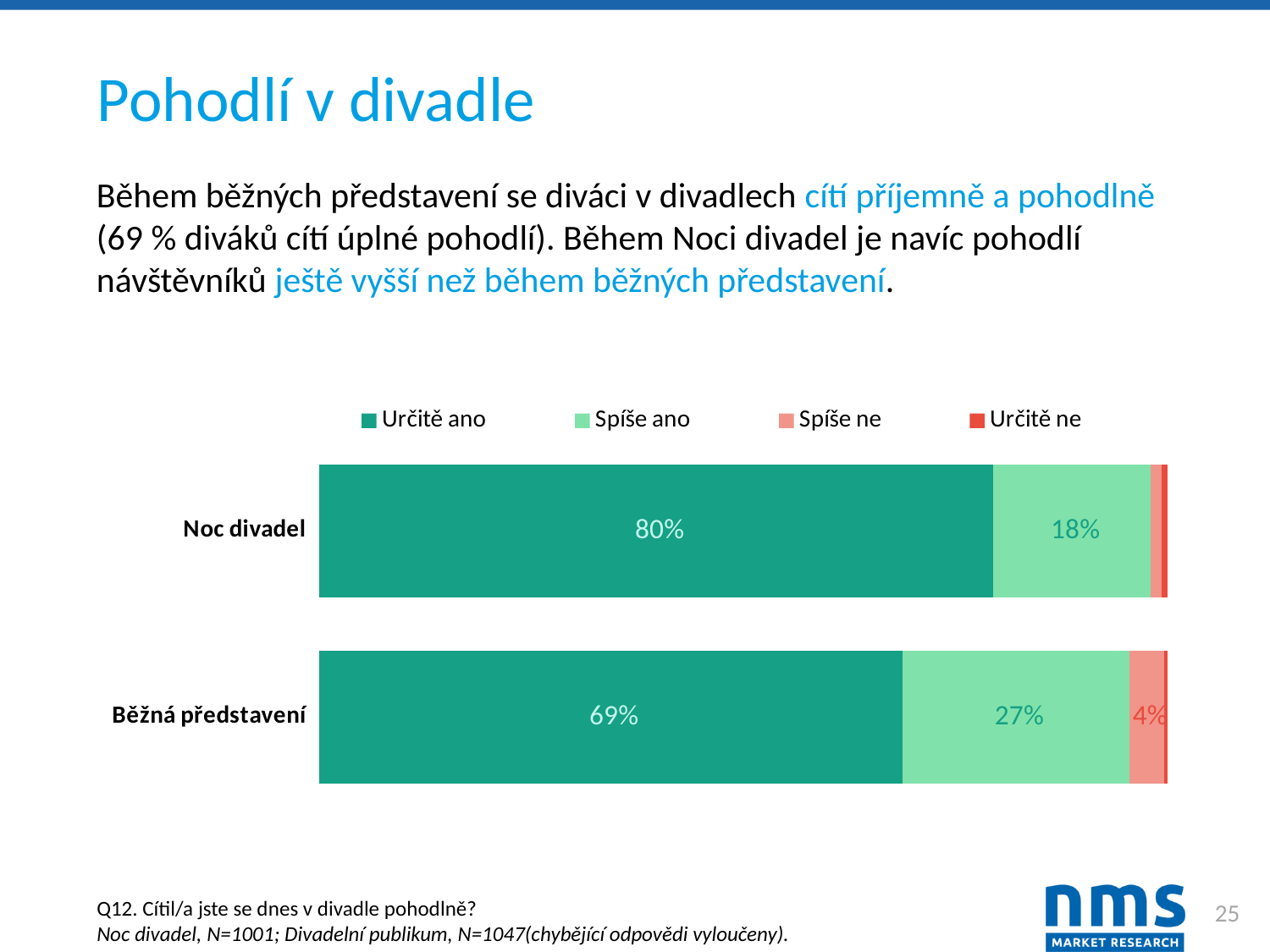
How many series does the legend list? 4 What is the difference between the "Určitě ano" values for Noc divadel and Běžná představení? 11% How many categories are plotted in the chart? 2 What is the value of "Spíše ne" for Běžná představení? 4% What is the value of "Spíše ano" for Noc divadel? 18% What is the difference between the "Spíše ano" values for Běžná představení and Noc divadel? 9% Which category has the higher "Určitě ano" value, Noc divadel or Běžná představení? Noc divadel What kind of chart is shown on the slide? stacked bar chart What is the value of "Spíše ano" for Běžná představení? 27% What is the value of "Určitě ano" for Běžná představení? 69% Which legend entry is shown in the darkest green colour? Určitě ano What is the value of "Určitě ano" for Noc divadel? 80%